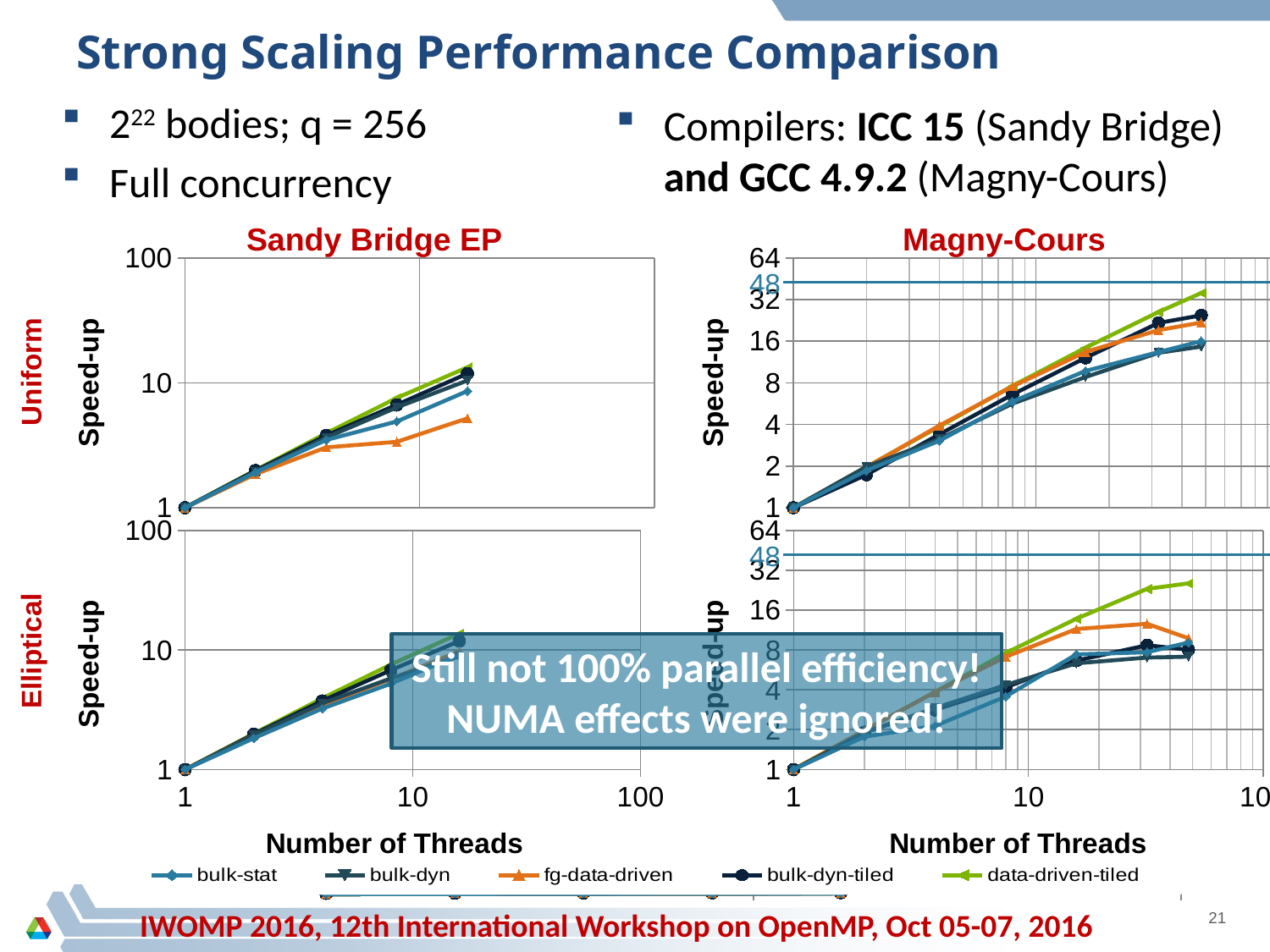
What kind of chart is the Sandy Bridge EP Uniform chart (top-left)? line chart What is the y-axis label of the Sandy Bridge EP charts? Speed-up In the Magny-Cours Uniform chart (top-right), which has the larger speed-up at the highest thread count, fg-data-driven or bulk-stat? fg-data-driven What is the x-axis label of the Magny-Cours charts? Number of Threads In the Sandy Bridge EP Uniform chart (top-left), is the speed-up of fg-data-driven at the highest thread count greater or less than 10? less How many series does the legend at the bottom of the slide list? 5 In the Sandy Bridge EP Uniform chart (top-left), which series has the lowest speed-up at the highest thread count? fg-data-driven In the Magny-Cours Elliptical chart (bottom-right), is the speed-up of data-driven-tiled at the highest thread count greater or less than 32? less In the Magny-Cours Uniform chart (top-right), is the speed-up of data-driven-tiled at the highest thread count greater or less than 32? greater In the Magny-Cours Uniform chart (top-right), which series has the highest speed-up at the highest thread count? data-driven-tiled In the Magny-Cours Uniform chart (top-right), does the speed-up rise or fall as the number of threads increases? rise